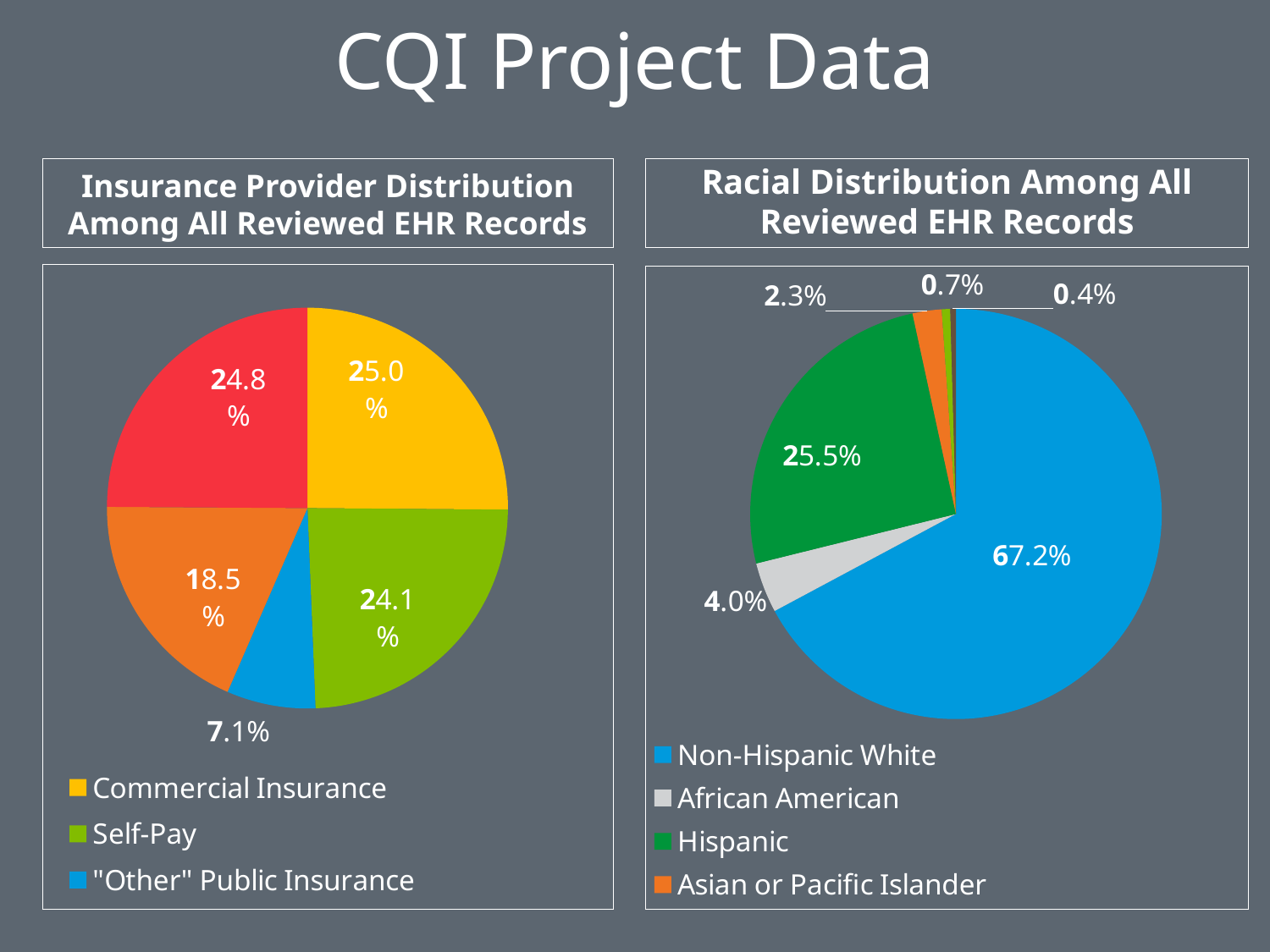
In the 'Insurance Provider Distribution Among All Reviewed EHR Records' chart, what share is Self-Pay? 24.1% What kind of chart is the 'Insurance Provider Distribution Among All Reviewed EHR Records' chart? Pie chart In the 'Insurance Provider Distribution Among All Reviewed EHR Records' chart, which labelled category has the smallest slice? "Other" Public Insurance In the 'Racial Distribution Among All Reviewed EHR Records' chart, what share is Asian or Pacific Islander? 2.3% In the 'Racial Distribution Among All Reviewed EHR Records' chart, which category has the largest slice? Non-Hispanic White In the 'Racial Distribution Among All Reviewed EHR Records' chart, what share is Hispanic? 25.5% In the 'Racial Distribution Among All Reviewed EHR Records' chart, how much larger is the Non-Hispanic White share than the Hispanic share? 41.7% In the 'Insurance Provider Distribution Among All Reviewed EHR Records' chart, how many slices does the pie have? 5